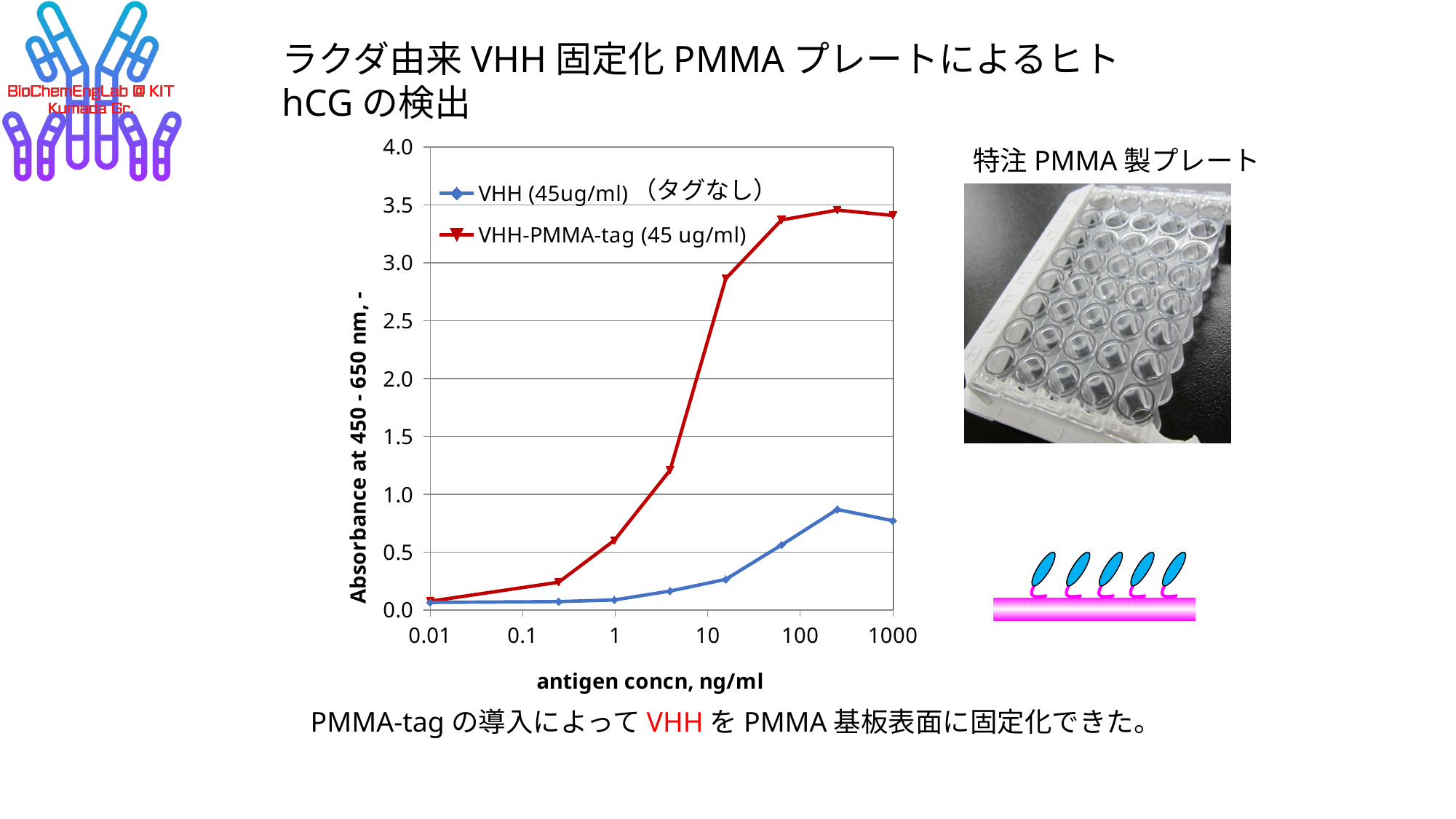
Is the absorbance for VHH (45ug/ml) at 1000 ng/ml greater or less than 1.0? less Which series is plotted in red? VHH-PMMA-tag (45 ug/ml) What is the label of the x axis of the chart? antigen concn, ng/ml How many series does the chart legend list? 2 What kind of chart is shown on the slide? line chart Does the absorbance for VHH-PMMA-tag (45 ug/ml) generally rise or fall as antigen concentration increases? rise How many data points are plotted for the VHH-PMMA-tag (45 ug/ml) series? 8 Is the absorbance for VHH (45ug/ml) at 1 ng/ml greater or less than 0.5? less Is the absorbance for VHH-PMMA-tag (45 ug/ml) at 1 ng/ml greater or less than 0.5? greater What is the label of the y axis of the chart? Absorbance at 450 - 650 nm, - At 1000 ng/ml, which series has the higher absorbance, VHH (45ug/ml) or VHH-PMMA-tag (45 ug/ml)? VHH-PMMA-tag (45 ug/ml)